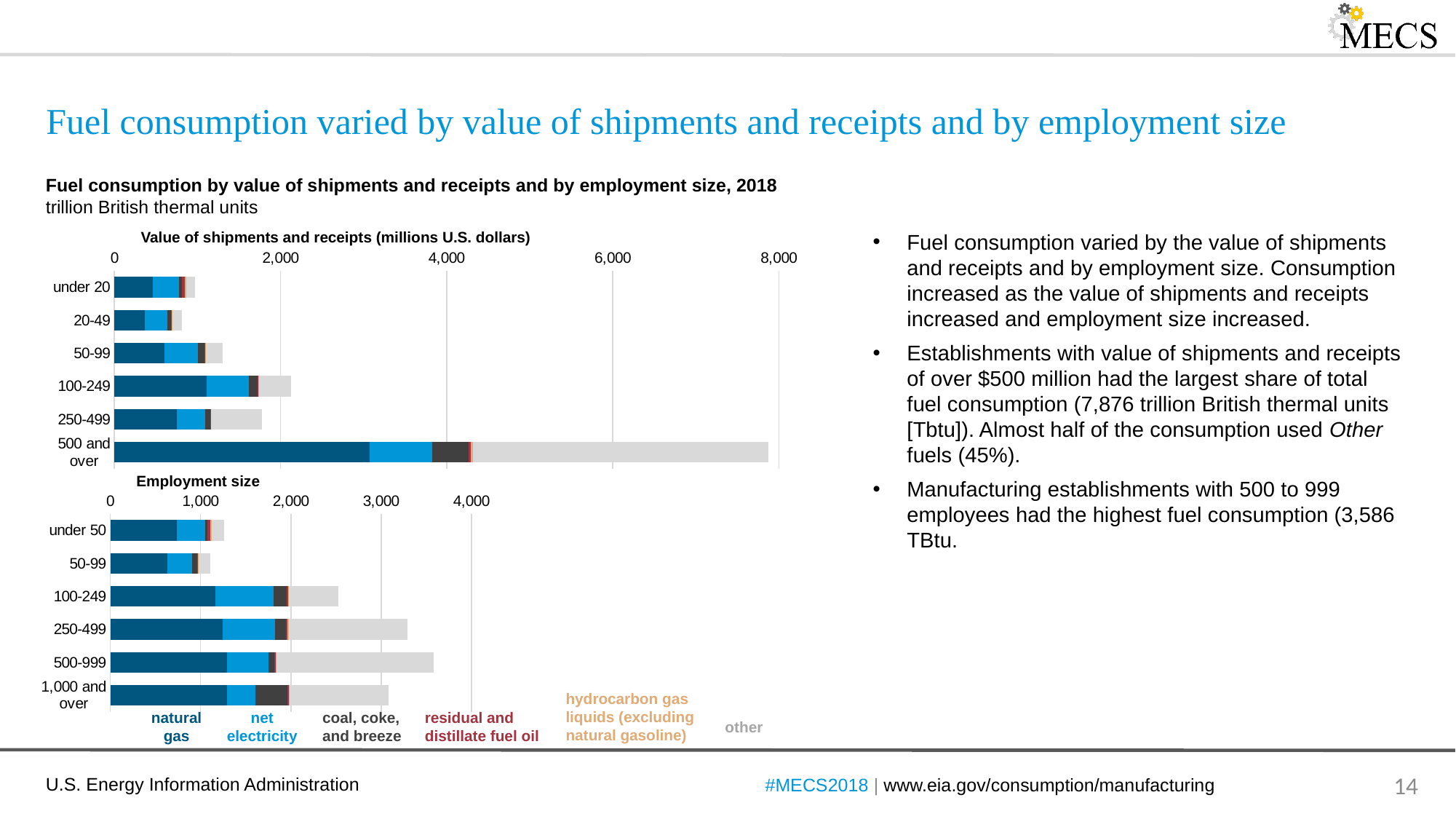
In the 'Employment size' chart, which category has the highest total fuel consumption? 500-999 What kind of chart is used on this slide to show fuel consumption by value of shipments and by employment size? bar chart In the charts, which fuel series is shown in light grey? other In the 'Value of shipments and receipts' chart, is the total fuel consumption for '500 and over' greater or less than 6,000? greater In the 'Employment size' chart, which has the larger total fuel consumption: '250-499' or '100-249'? 250-499 In the 'Employment size' chart, which category has the lowest total fuel consumption? 50-99 In the 'Value of shipments and receipts' chart, how many value-of-shipments categories are plotted? 6 In the 'Value of shipments and receipts' chart, which category has the lowest total fuel consumption? 20-49 In the 'Employment size' chart, is the total fuel consumption for '100-249' greater or less than 2,000? greater How many fuel series does the legend at the bottom of the charts list? 6 In the 'Value of shipments and receipts' chart, which category has the highest total fuel consumption? 500 and over In the 'Employment size' chart, how many employment-size categories are plotted? 6